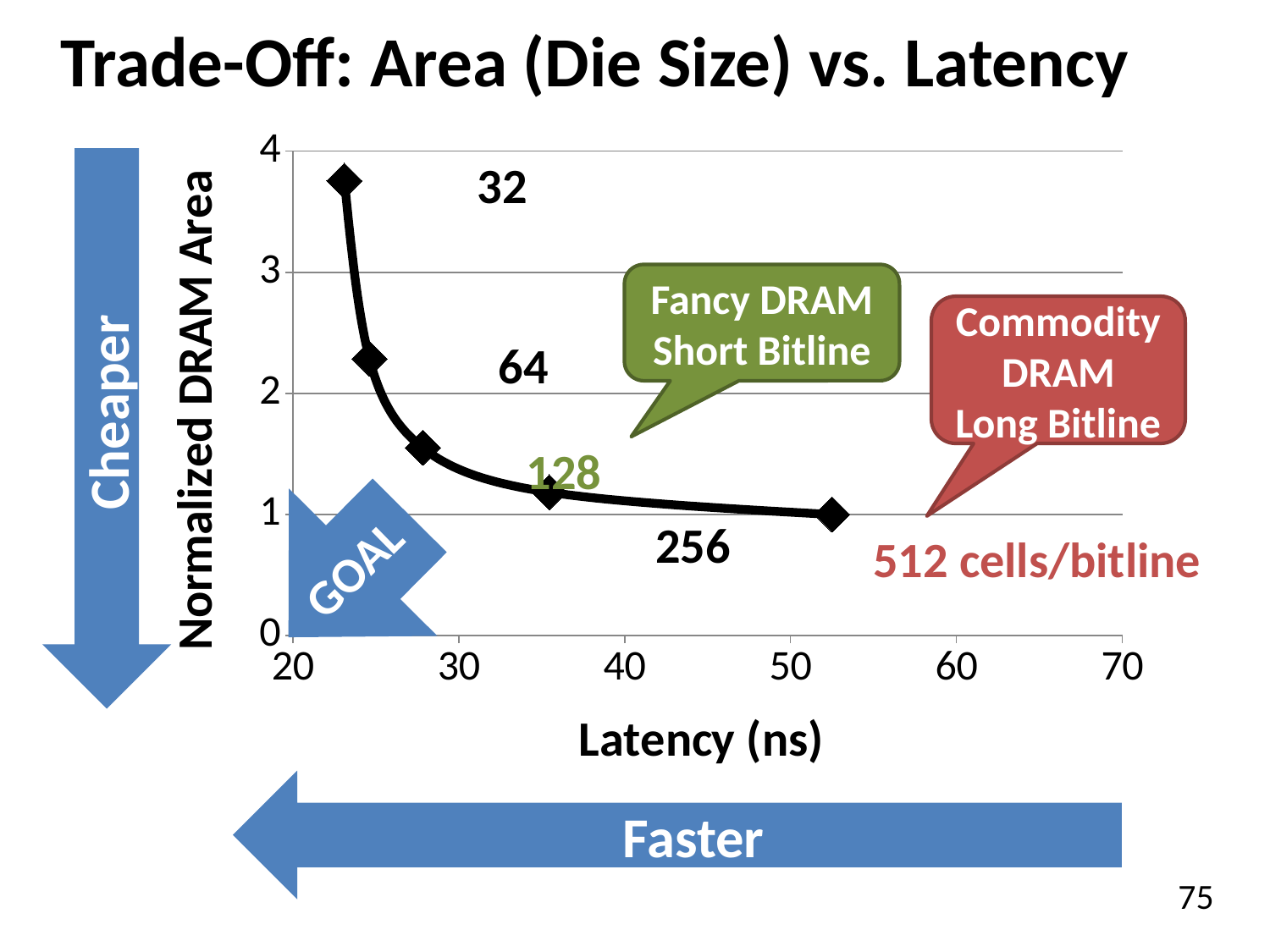
Is the normalized DRAM area for the 128 cells/bitline point greater or less than 2? less Which cells/bitline configuration has the highest normalized DRAM area? 32 Which cells/bitline configuration has the lowest normalized DRAM area? 512 Is the normalized DRAM area for the 32 cells/bitline point greater or less than 3? greater Is the latency for the 512 cells/bitline point greater or less than 50 ns? greater What kind of chart is shown on the slide? line chart Which has a larger normalized DRAM area, the 64 or the 256 cells/bitline point? 64 How many data points are plotted on the curve? 5 What is the normalized DRAM area for the 512 cells/bitline point? 1 As latency increases along the x axis, does the normalized DRAM area rise or fall? fall